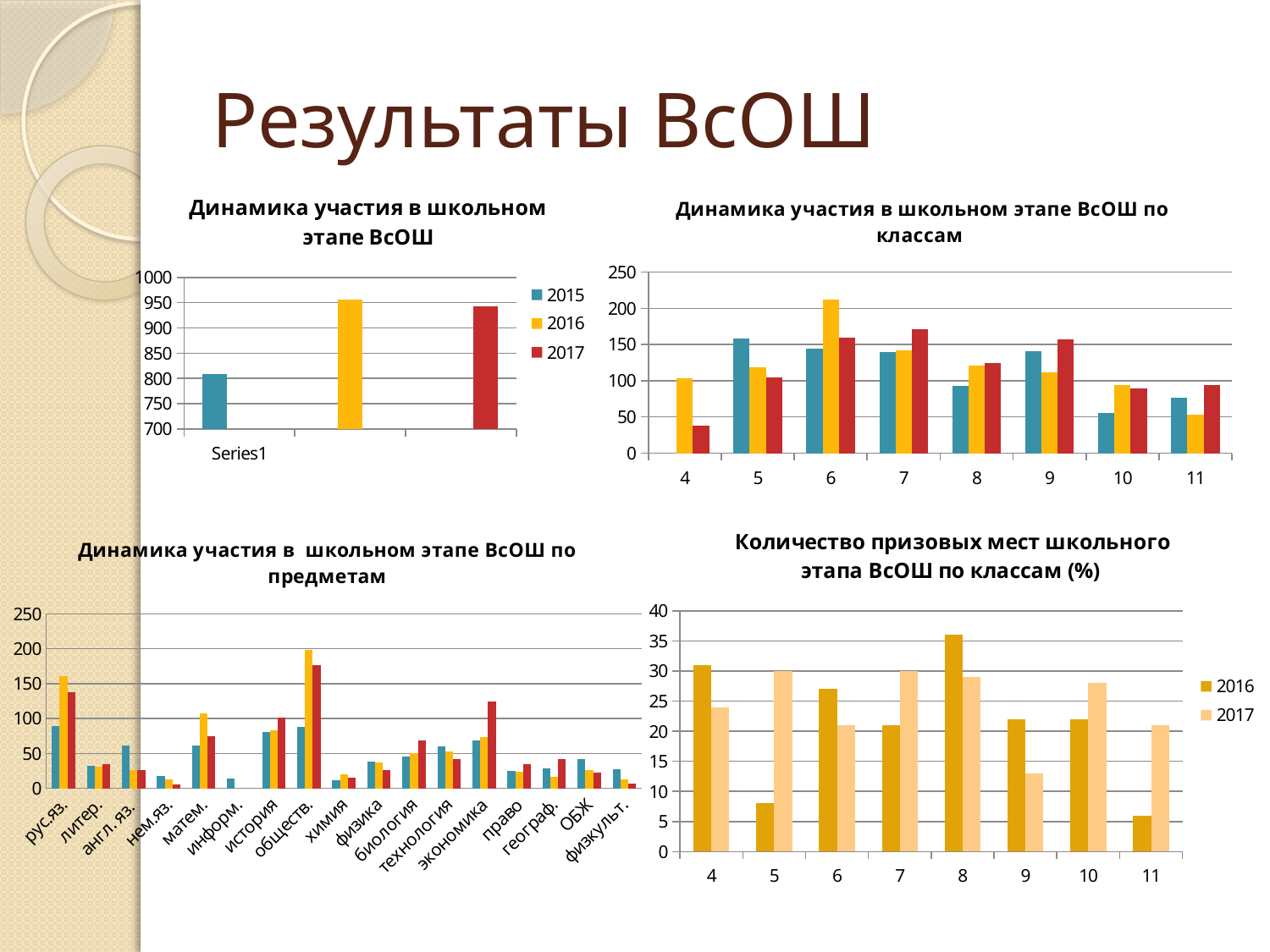
In the chart 'Динамика участия в школьном этапе ВсОШ' (top left), which year has the lowest value? 2015 In the chart 'Динамика участия в школьном этапе ВсОШ' (top left), how many series does the legend list? 3 In the chart 'Динамика участия в школьном этапе ВсОШ по классам' (top right), how many classes are shown on the x axis? 8 In the chart 'Количество призовых мест школьного этапа ВсОШ по классам (%)' (bottom right), which class has the highest 2016 value? 8 In the chart 'Динамика участия в школьном этапе ВсОШ по классам' (top right), which class has the highest 2016 value? 6 In the chart 'Динамика участия в школьном этапе ВсОШ' (top left), is the value for 2015 greater or less than 850? less In the chart 'Динамика участия в школьном этапе ВсОШ по предметам' (bottom left), is the 2016 value for обществ. greater or less than 150? greater In the chart 'Количество призовых мест школьного этапа ВсОШ по классам (%)' (bottom right), for class 5, which year has the larger value, 2016 or 2017? 2017 In the chart 'Динамика участия в школьном этапе ВсОШ по классам' (top right), is the 2016 value for class 6 greater or less than 200? greater In the chart 'Динамика участия в школьном этапе ВсОШ по предметам' (bottom left), which subject has the highest 2016 value? обществ. In the chart 'Количество призовых мест школьного этапа ВсОШ по классам (%)' (bottom right), which class has the lowest 2016 value? 11 What type of chart is 'Количество призовых мест школьного этапа ВсОШ по классам (%)' (bottom right)? bar chart